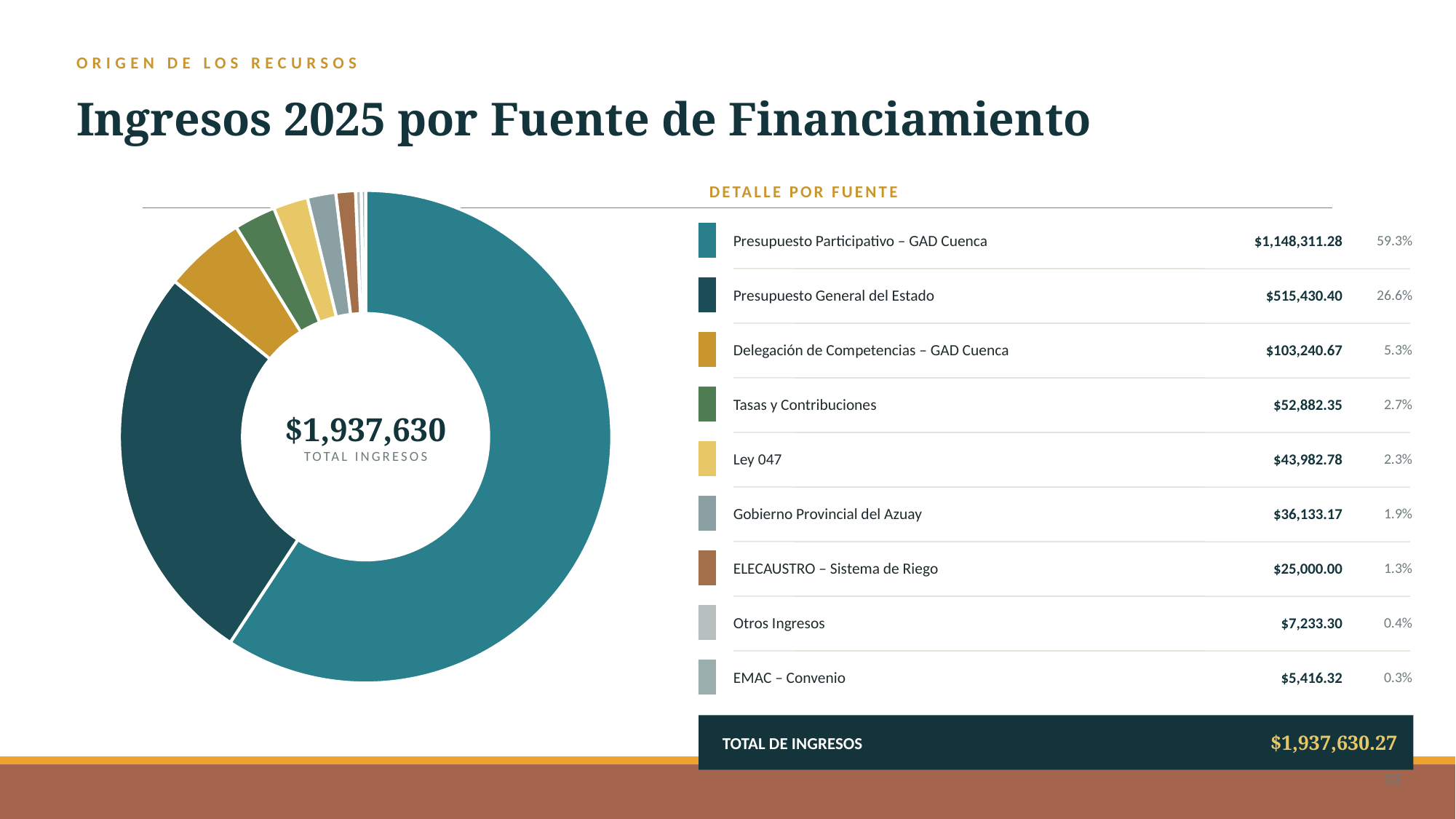
How many funding sources are listed in the chart? 9 What is the difference between Presupuesto Participativo – GAD Cuenca and Presupuesto General del Estado? $632,880.88 What kind of chart is shown on the slide? Pie chart (donut) Which funding source has the highest value? Presupuesto Participativo – GAD Cuenca Which funding source has the lowest value? EMAC – Convenio What is the total of all income sources shown? $1,937,630.27 What is the difference between Delegación de Competencias – GAD Cuenca and Tasas y Contribuciones? $50,358.32 What percentage share does Delegación de Competencias – GAD Cuenca represent? 5.3% What is the title of the slide containing the chart? Ingresos 2025 por Fuente de Financiamiento What is the value for ELECAUSTRO – Sistema de Riego? $25,000.00 Which is larger, Tasas y Contribuciones or Ley 047? Tasas y Contribuciones What is the value for Presupuesto General del Estado? $515,430.40